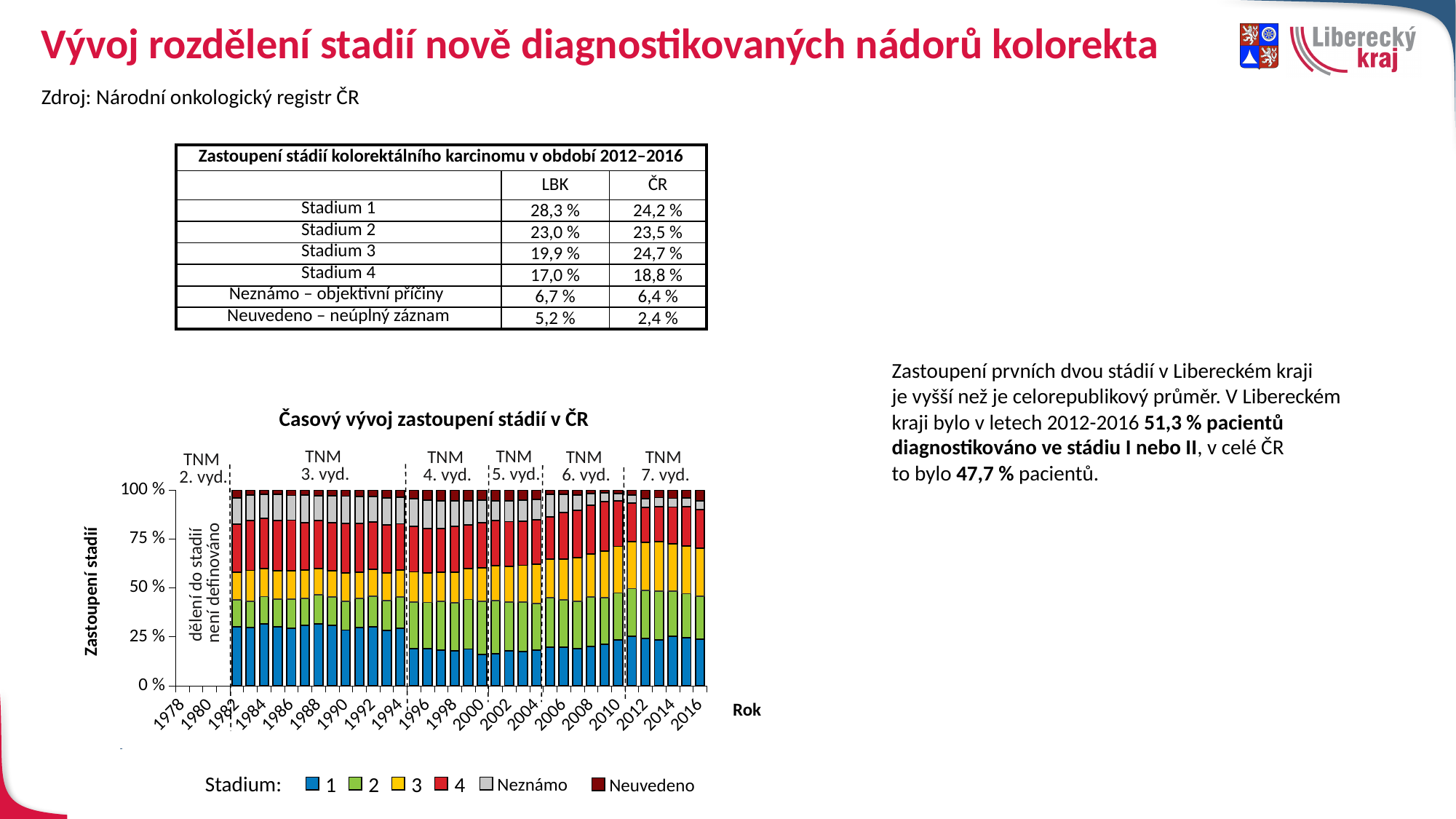
In the chart "Časový vývoj zastoupení stádií v ČR", does the share of Neznámo rise or fall between 1982 and 2016? Fall What kind of chart is "Časový vývoj zastoupení stádií v ČR"? Stacked bar chart In the chart "Časový vývoj zastoupení stádií v ČR", is the share of Stadium 1 in 1982 greater or less than 25 %? greater In the chart "Časový vývoj zastoupení stádií v ČR", is the share of Stadium 1 in 1996 greater or less than 25 %? less In the chart "Časový vývoj zastoupení stádií v ČR", does the share of Stadium 1 rise or fall between 1996 and 2016? Rise How many series does the legend of the chart "Časový vývoj zastoupení stádií v ČR" list? 6 In the chart "Časový vývoj zastoupení stádií v ČR", does the share of Stadium 1 rise or fall between 1982 and 1996? Fall In the chart "Časový vývoj zastoupení stádií v ČR", is the combined share of Stadium 1, 2 and 3 in 1982 greater or less than 50 %? greater In the chart "Časový vývoj zastoupení stádií v ČR", what colour represents Stadium 1? Blue In the chart "Časový vývoj zastoupení stádií v ČR", which legend entries are listed under "Stadium:"? 1, 2, 3, 4, Neznámo, Neuvedeno In the chart "Časový vývoj zastoupení stádií v ČR", how many TNM editions are marked above the bars? 6 In the chart "Časový vývoj zastoupení stádií v ČR", what is the total of each stacked bar? 100 %